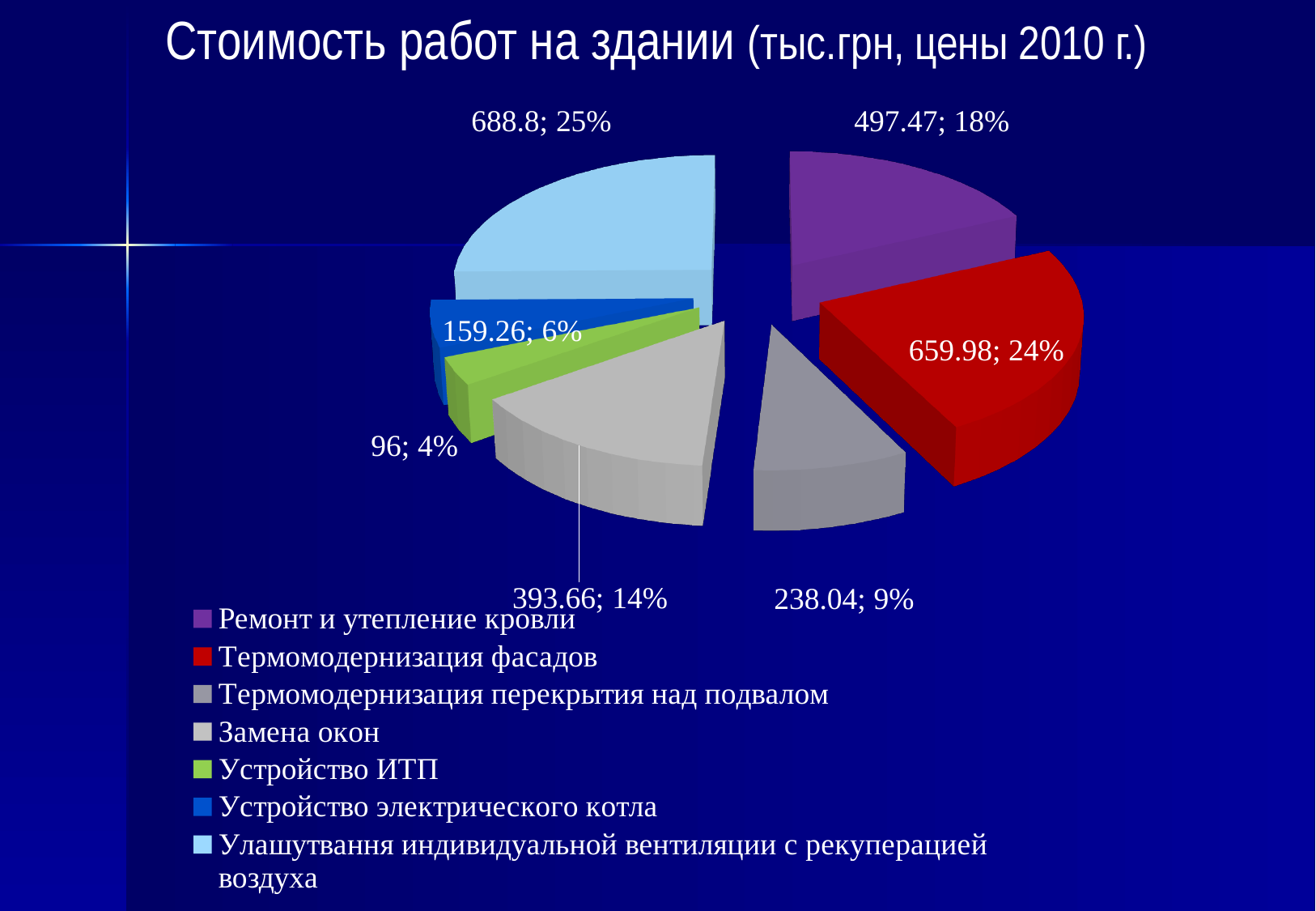
What is the difference between the values for Термомодернизация фасадов and Ремонт и утепление кровли? 162.51 What share of the pie does Улашутвання индивидуальной вентиляции с рекуперацией воздуха represent? 25% What is the title of the chart? Стоимость работ на здании (тыс.грн, цены 2010 г.) What is the value for Термомодернизация фасадов? 659.98 Which category has the largest value? Улашутвання индивидуальной вентиляции с рекуперацией воздуха Which is larger, the value for Термомодернизация перекрытия над подвалом or the value for Устройство электрического котла? Термомодернизация перекрытия над подвалом Which category has the smallest value? Устройство ИТП What is the value for Устройство ИТП? 96 What share of the pie does Замена окон represent? 14% What type of chart is shown on the slide? pie chart What is the value for Ремонт и утепление кровли? 497.47 How many slices does the pie chart have? 7